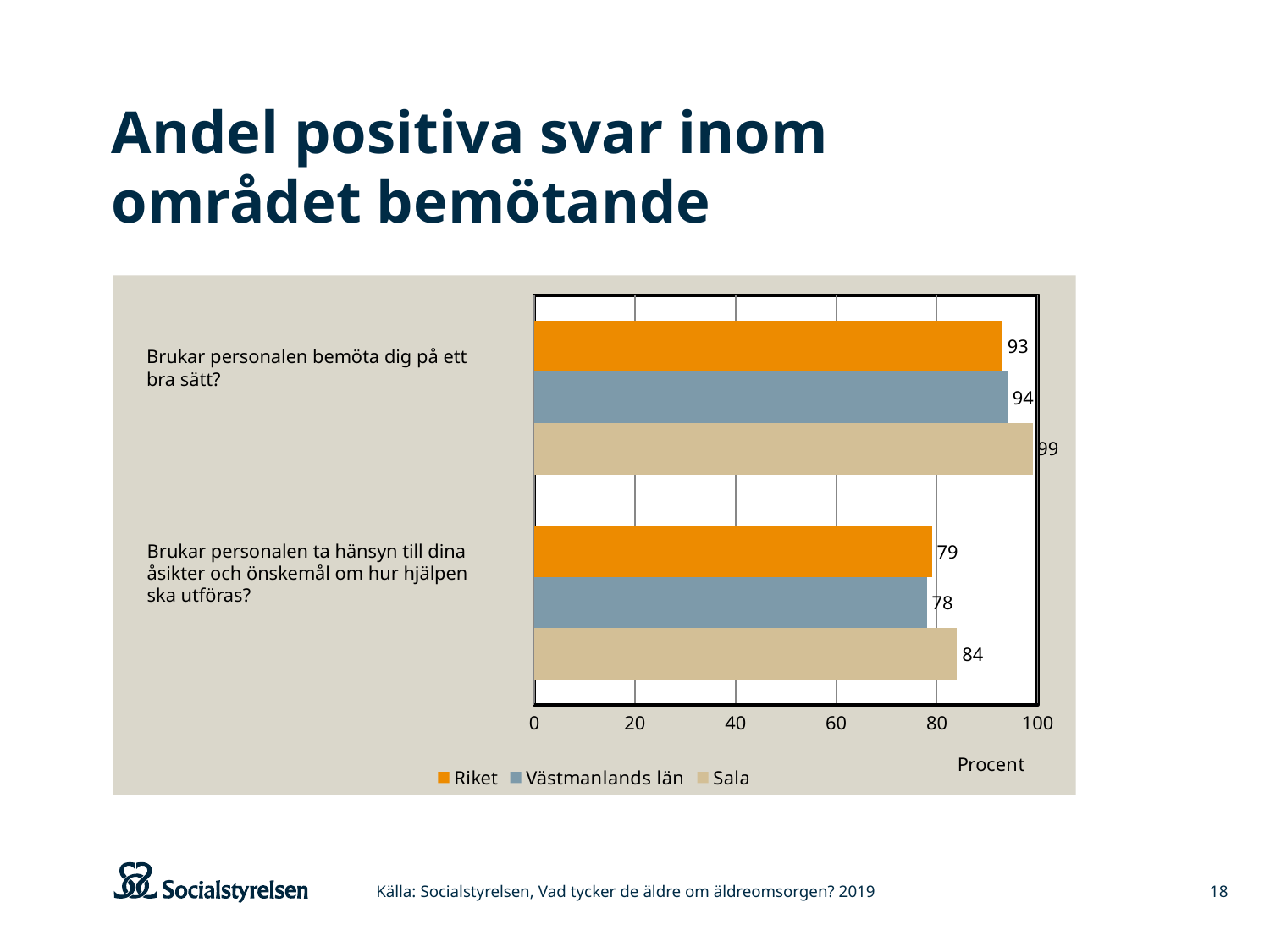
Which is larger: the Riket value for "Brukar personalen bemöta dig på ett bra sätt?" or the Riket value for "Brukar personalen ta hänsyn till dina åsikter och önskemål om hur hjälpen ska utföras?"? Brukar personalen bemöta dig på ett bra sätt? How many series does the legend list? 3 What kind of chart is shown on the slide? Bar chart What is the label on the horizontal axis of the chart? Procent What is the value for Riket for the question "Brukar personalen ta hänsyn till dina åsikter och önskemål om hur hjälpen ska utföras?"? 79 What is the difference between the Sala value and the Riket value for the question "Brukar personalen bemöta dig på ett bra sätt?"? 6 What is the difference between the Sala value and the Västmanlands län value for the question "Brukar personalen ta hänsyn till dina åsikter och önskemål om hur hjälpen ska utföras?"? 6 Which series has the lowest value for the question "Brukar personalen ta hänsyn till dina åsikter och önskemål om hur hjälpen ska utföras?"? Västmanlands län What is the value for Sala for the question "Brukar personalen bemöta dig på ett bra sätt?"? 99 Which series has the highest value for the question "Brukar personalen ta hänsyn till dina åsikter och önskemål om hur hjälpen ska utföras?"? Sala Is the Västmanlands län value for "Brukar personalen ta hänsyn till dina åsikter och önskemål om hur hjälpen ska utföras?" greater or less than 80? less What is the value for Västmanlands län for the question "Brukar personalen bemöta dig på ett bra sätt?"? 94